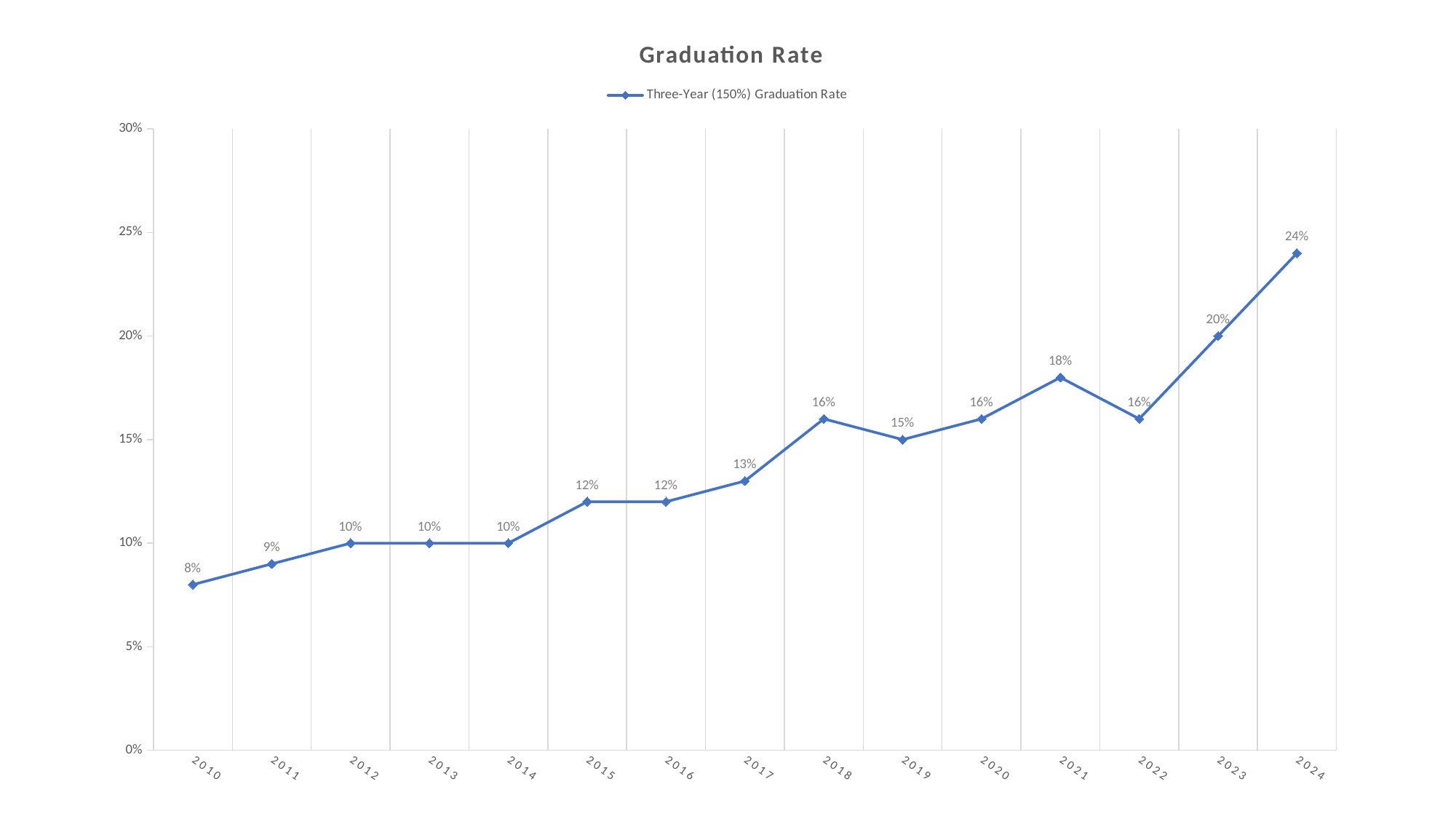
How many years are plotted on the x axis? 15 What is the difference between the graduation rate in 2024 and in 2010? 16% What kind of chart is shown on the slide? Line chart What is the title of the chart? Graduation Rate Which year has a higher graduation rate, 2021 or 2022? 2021 Which year has the highest Three-Year (150%) Graduation Rate? 2024 Is the graduation rate for 2023 greater or less than 15%? greater What is the Three-Year (150%) Graduation Rate for 2024? 24% What is the Three-Year (150%) Graduation Rate for 2010? 8% How many series does the legend list? 1 Which year has the lowest Three-Year (150%) Graduation Rate? 2010 What is the Three-Year (150%) Graduation Rate for 2019? 15%